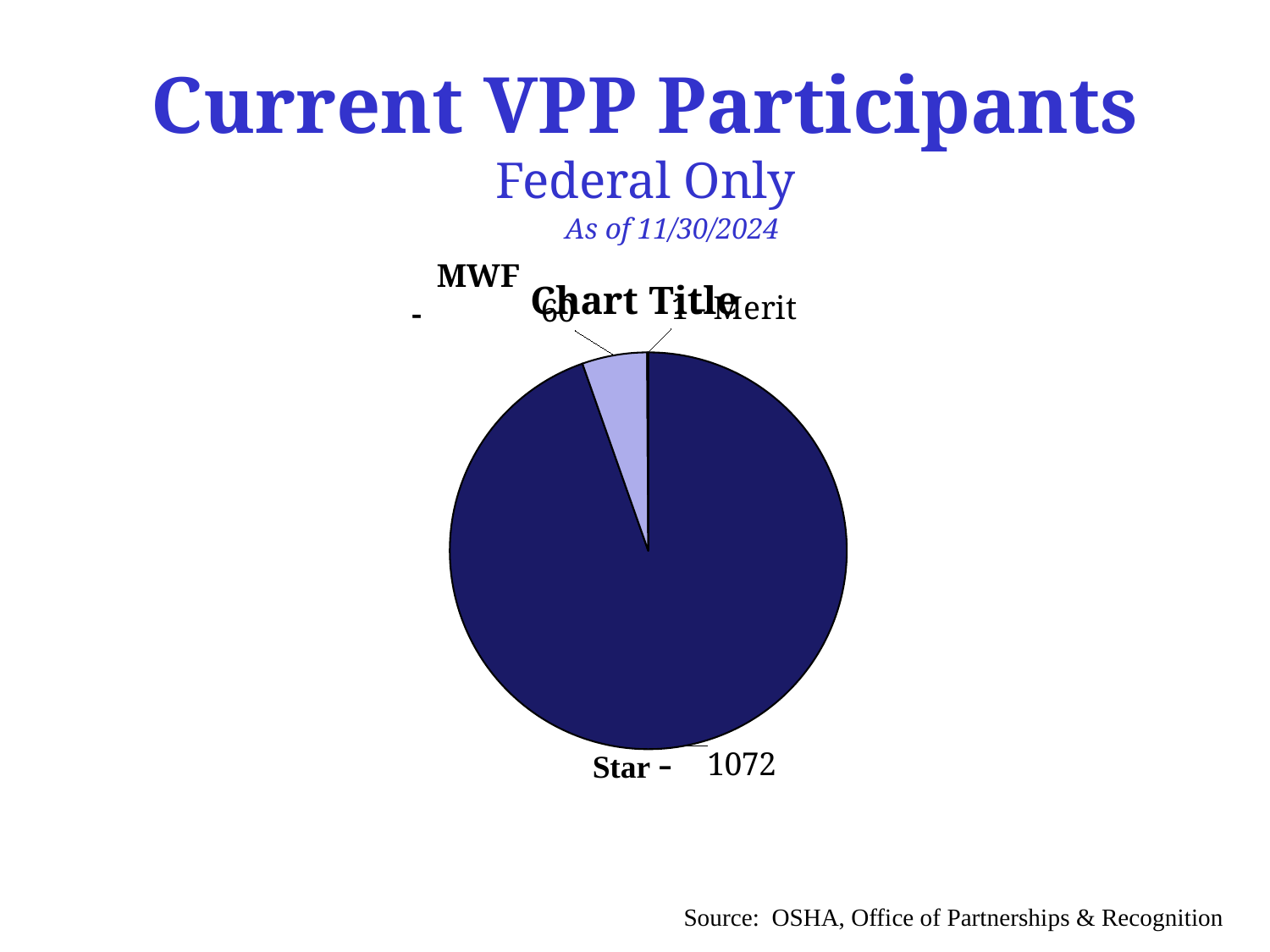
What kind of chart is shown on the slide? pie chart Which slice is larger, MWF or Merit? MWF Which category has the smallest slice of the pie? Merit Which category has the largest slice of the pie? Star What share of the pie does the Star slice represent, to one decimal place? 94.6% How many Star participants are shown in the pie chart? 1072 What date is the data on the slide current as of? 11/30/2024 What is the value shown for the MWF slice? 60 What is the value shown for the Merit slice? 1 What is the total number of participants across all three slices? 1133 How many categories are shown in the pie chart? 3 How many more Star participants are there than MWF participants? 1012